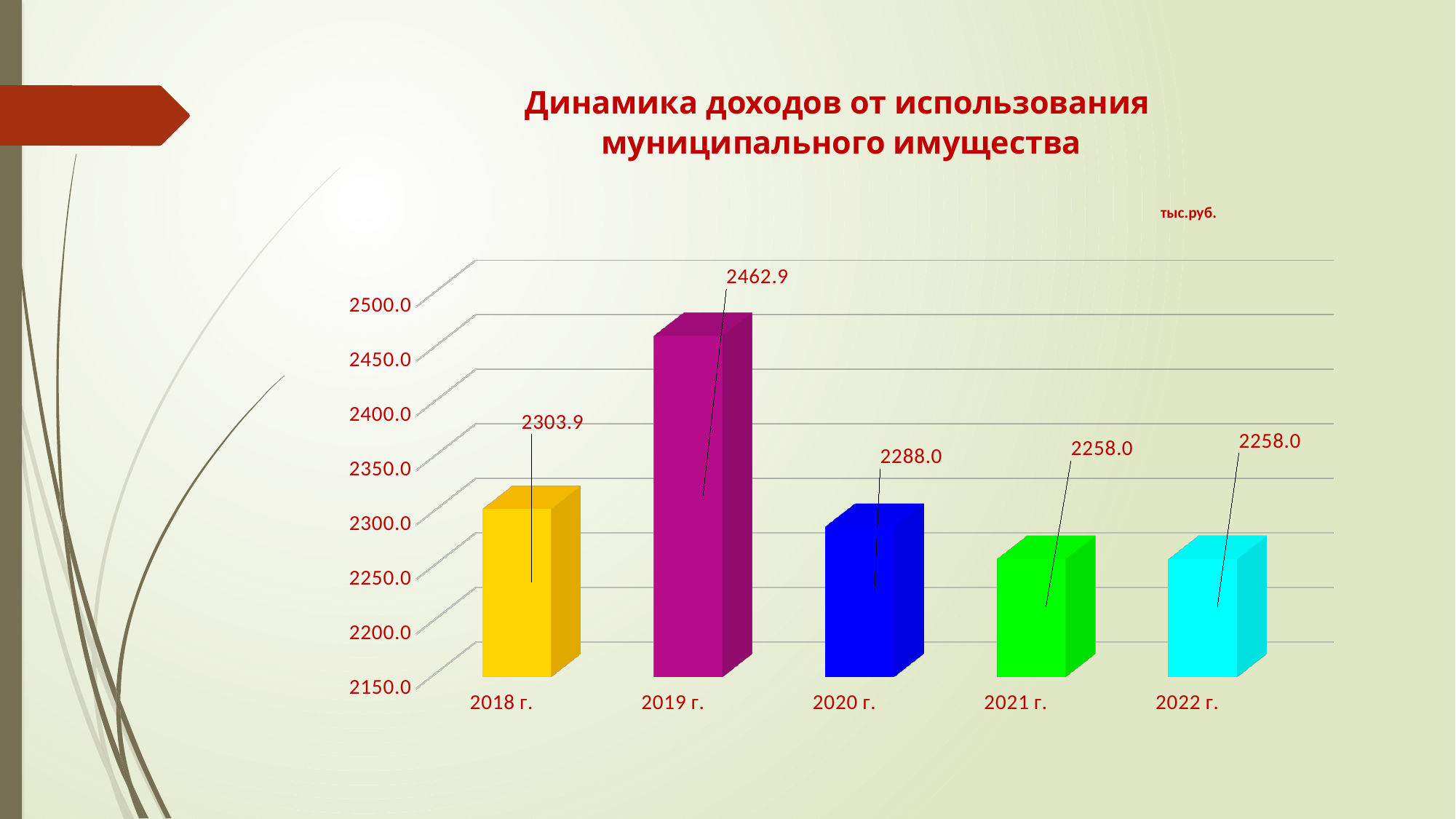
What is the value for 2019 г.? 2462.9 What is the value for 2022 г.? 2258.0 Do the values rise or fall from 2019 г. to 2022 г.? fall What is the value for 2020 г.? 2288.0 What kind of chart is shown on the slide? bar chart Which year has the highest value? 2019 г. How many years are shown on the x axis? 5 What is the difference between the values for 2019 г. and 2018 г.? 159.0 Is the value for 2019 г. greater or less than 2400.0? greater What is the value for 2018 г.? 2303.9 What is the difference between the values for 2020 г. and 2021 г.? 30.0 Which is larger, the value for 2018 г. or the value for 2020 г.? 2018 г.